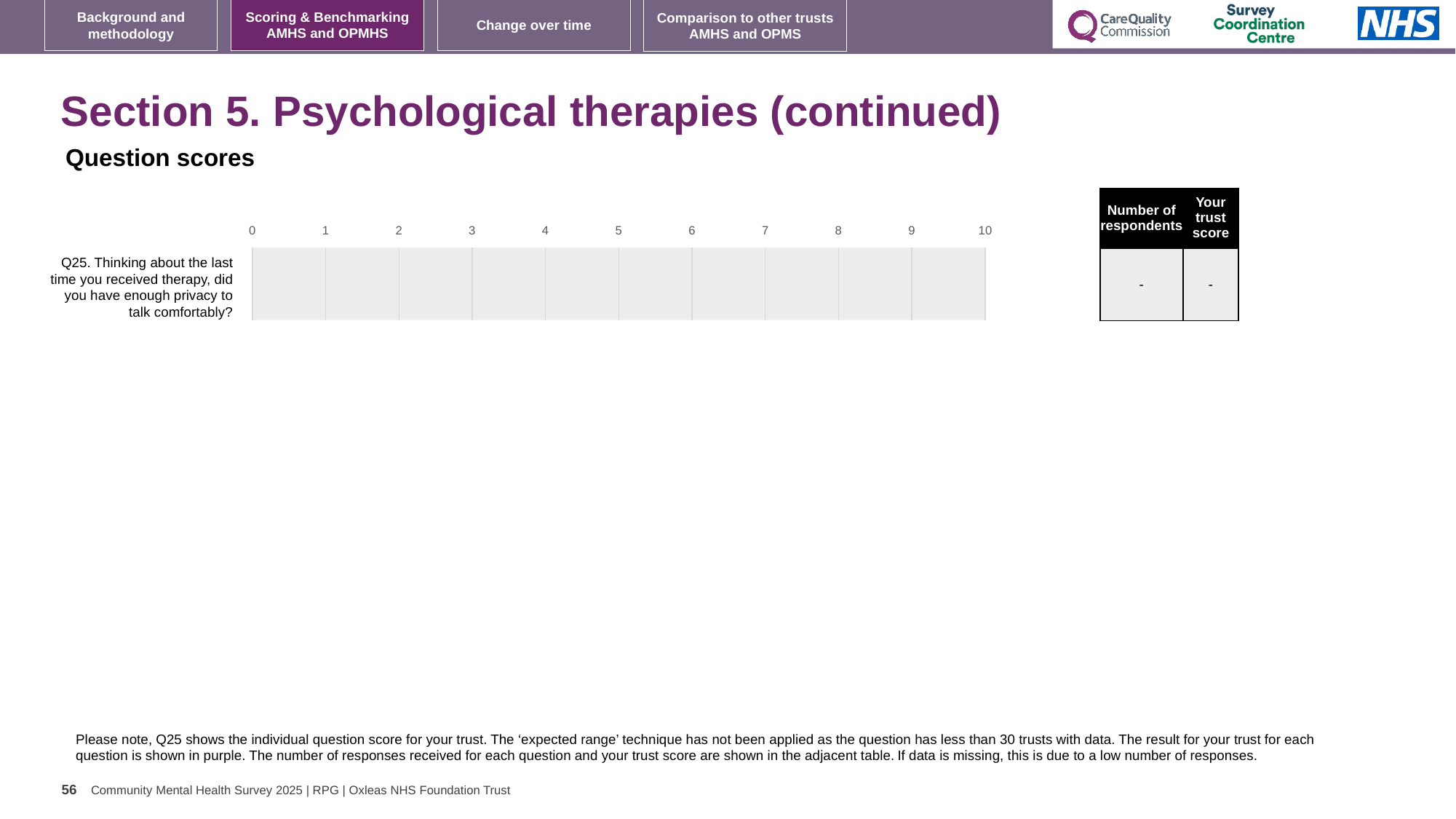
How many questions (categories) are plotted on the chart? 1 What is the highest value shown on the chart's x axis? 10 What value is shown in the 'Number of respondents' column for Q25? - What value is shown in the 'Your trust score' column for Q25? - What kind of chart is shown on the slide? bar chart What is the lowest value shown on the chart's x axis? 0 Which question number is the single category on the chart? Q25 Is a bar plotted for Q25 on the chart? No